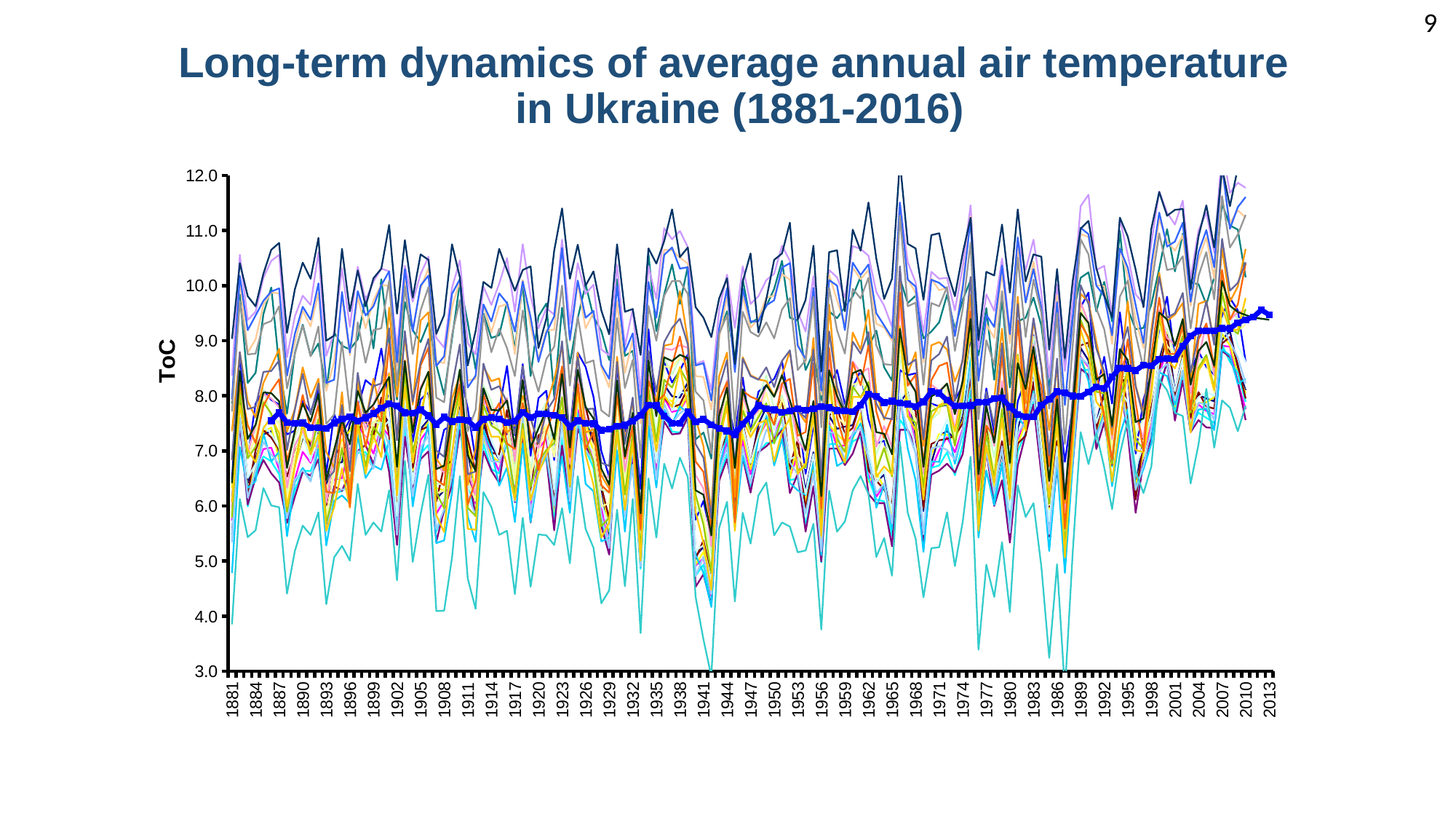
Is the value of the thick dark blue line at 1887 greater or less than 8.0? less Is the thick dark blue line higher at 1929 or at 2007? 2007 Is the value of the thick dark blue line at 1929 greater or less than 8.0? less Does the thick dark blue line rise or fall overall from left to right across the chart? rise Is the thick dark blue line higher at 2013 or at 1887? 2013 Is the value of the thick dark blue line at 2001 greater or less than 8.0? greater What is the title of the chart? Long-term dynamics of average annual air temperature in Ukraine (1881-2016) What is the label on the vertical axis of the chart? ToC What kind of chart is shown on the slide? line chart